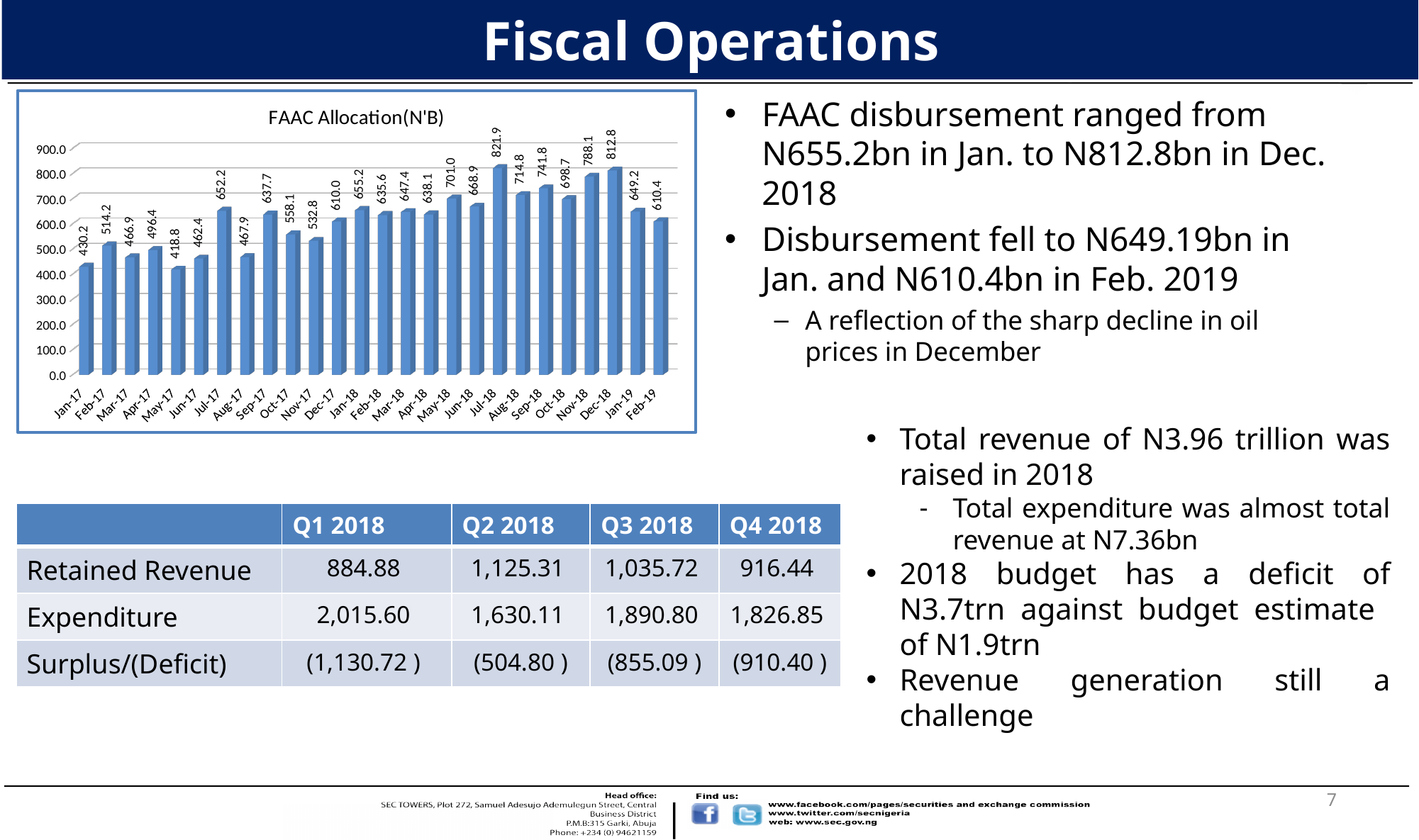
What is the FAAC allocation value for Jul-18? 821.9 What is the FAAC allocation value for Feb-19? 610.4 Is the FAAC allocation for Jul-17 greater or less than 600.0? greater What is the title of the bar chart on the slide? FAAC Allocation(N'B) What is the difference between the FAAC allocation for Dec-18 and Jan-18? 157.6 Do the FAAC allocation values rise or fall from Dec-18 to Feb-19? fall Which month has the lowest FAAC allocation in the chart? May-17 What is the FAAC allocation value for May-17? 418.8 Which month has a larger FAAC allocation, Feb-17 or Mar-17? Feb-17 Which month has the highest FAAC allocation in the chart? Jul-18 What kind of chart is the FAAC Allocation(N'B) chart? bar chart How many months are plotted in the FAAC Allocation chart? 26